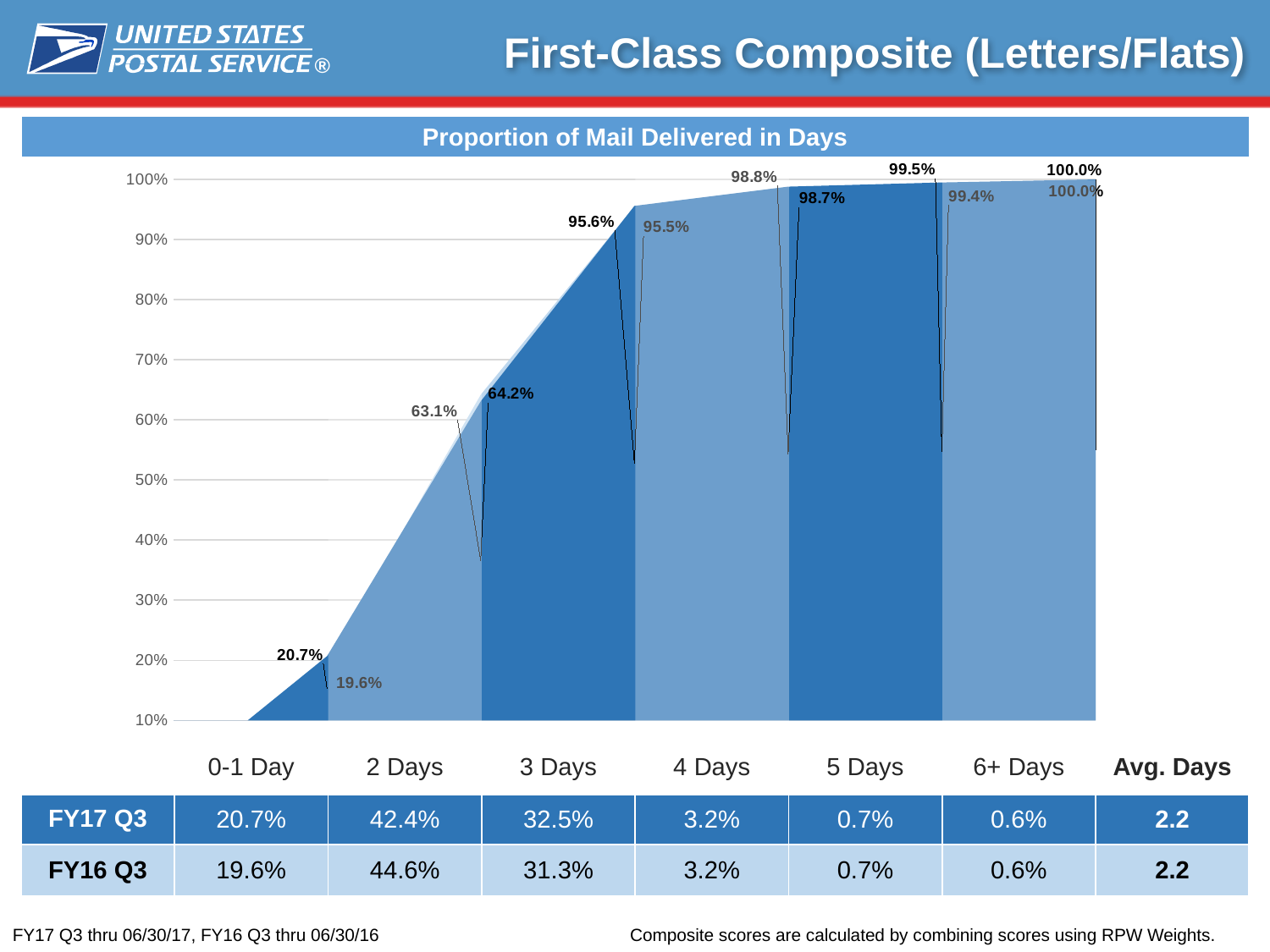
What cumulative value is labeled in bold at 3 Days? 95.6% Is the cumulative value labeled at 0-1 Day (20.7%) greater or less than 30%? less In the table below the chart, what is the FY17 Q3 value for 2 Days? 42.4% Which is larger at 4 Days: the bold label or the grey label? the bold label (98.8%) In the table below the chart, what is the Avg. Days value for FY16 Q3? 2.2 Do the plotted cumulative values rise or fall from 0-1 Day to 6+ Days? rise What is the higher of the two cumulative values labeled at 0-1 Day? 20.7% What is the title of the chart? Proportion of Mail Delivered in Days How many day categories are shown along the x axis of the chart? 6 What kind of chart is used to show the proportion of mail delivered in days? area chart What is the lower of the two cumulative values labeled at 2 Days? 63.1% What is the difference between the two cumulative values labeled at 2 Days (64.2% and 63.1%)? 1.1 percentage points